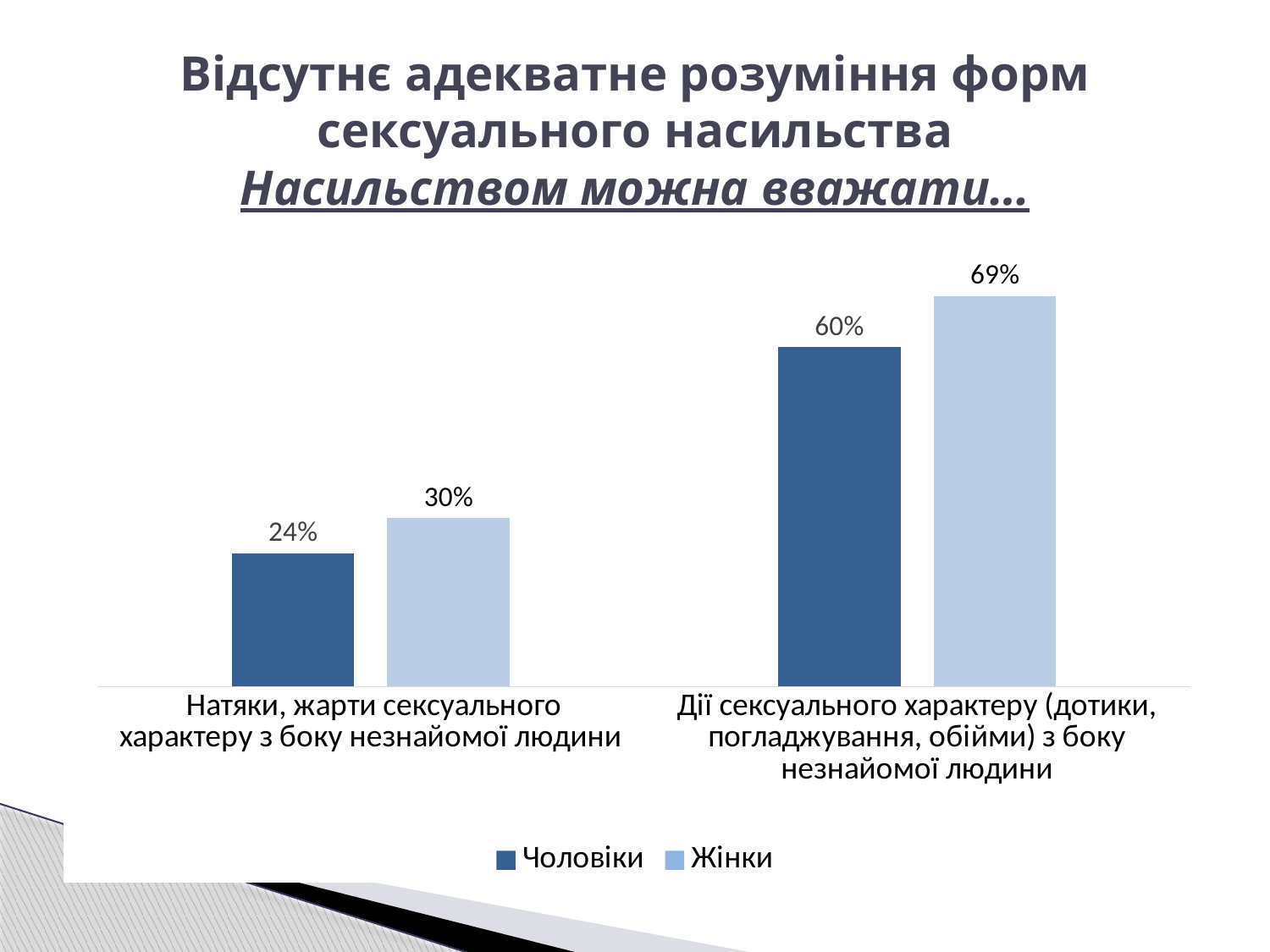
What is the value for Жінки in the category "Натяки, жарти сексуального характеру з боку незнайомої людини"? 30% What is the value for Чоловіки in the category "Натяки, жарти сексуального характеру з боку незнайомої людини"? 24% Which is larger: the Чоловіки value for "Дії сексуального характеру" or the Жінки value for "Натяки, жарти сексуального характеру"? Чоловіки value for "Дії сексуального характеру" What is the difference between Жінки and Чоловіки in the category "Натяки, жарти сексуального характеру з боку незнайомої людини"? 6% What is the value for Чоловіки in the category "Дії сексуального характеру (дотики, погладжування, обійми) з боку незнайомої людини"? 60% Which series has the lowest value on the chart? Чоловіки What kind of chart is shown on the slide? Bar chart How many series does the legend list? 2 What is the difference between Жінки and Чоловіки in the category "Дії сексуального характеру (дотики, погладжування, обійми) з боку незнайомої людини"? 9% Which series has the highest value on the chart? Жінки What is the value for Жінки in the category "Дії сексуального характеру (дотики, погладжування, обійми) з боку незнайомої людини"? 69% How many categories are shown on the x axis? 2